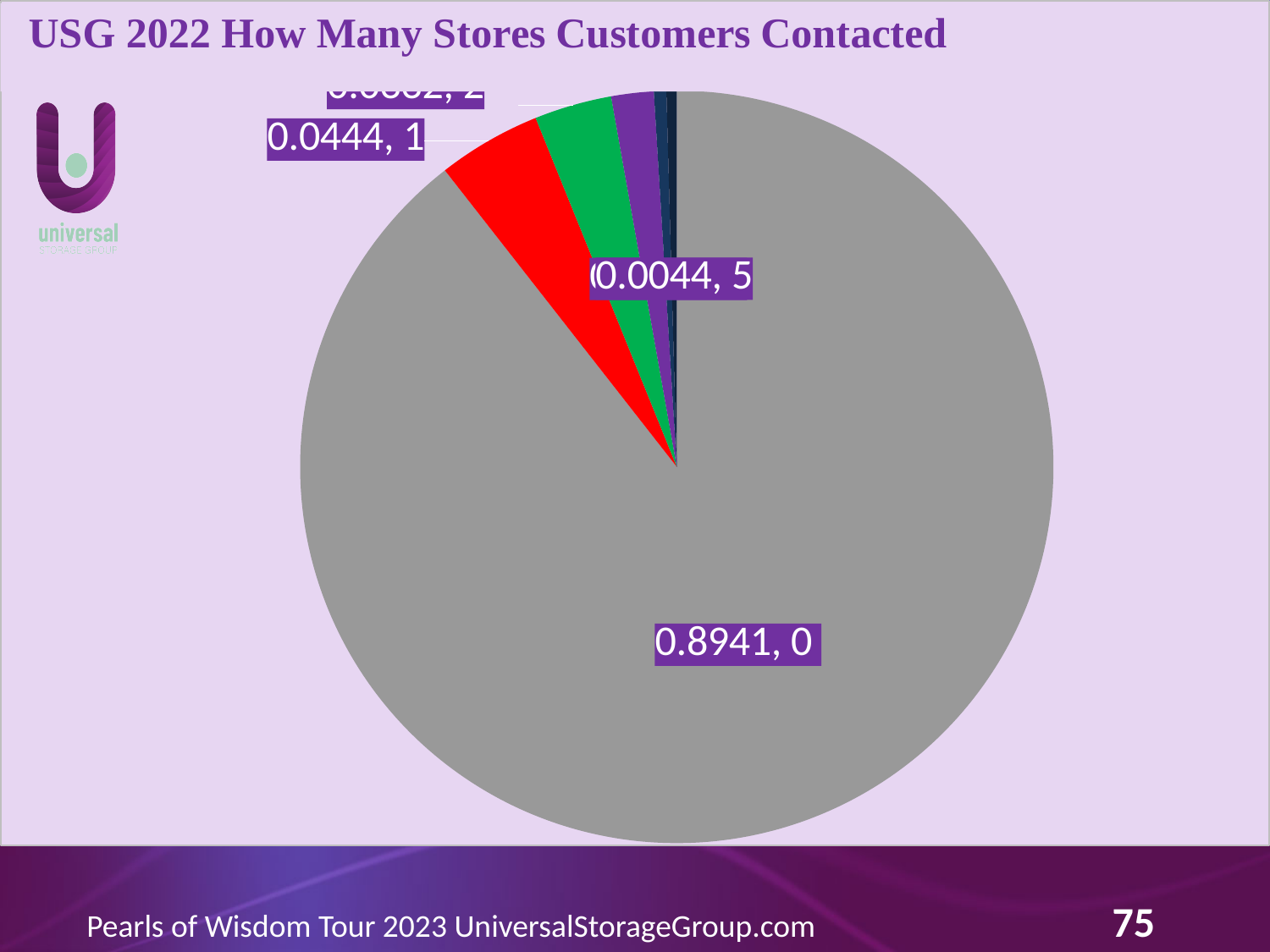
What is the title of the chart? USG 2022 How Many Stores Customers Contacted Which slice is larger, the one labelled 0 or the one labelled 1? 0 What kind of chart is shown on the slide? pie chart What value is shown for the slice labelled 0? 0.8941 What value is shown for the slice labelled 5? 0.0044 What value is shown for the slice labelled 1? 0.0444 What colour is the largest slice of the pie? gray Which category has the largest slice of the pie? 0 Which slice is larger, the one labelled 1 or the one labelled 5? 1 What is the difference between the values for the slices labelled 1 and 5? 0.0400 What is the difference between the values for the slices labelled 0 and 1? 0.8497